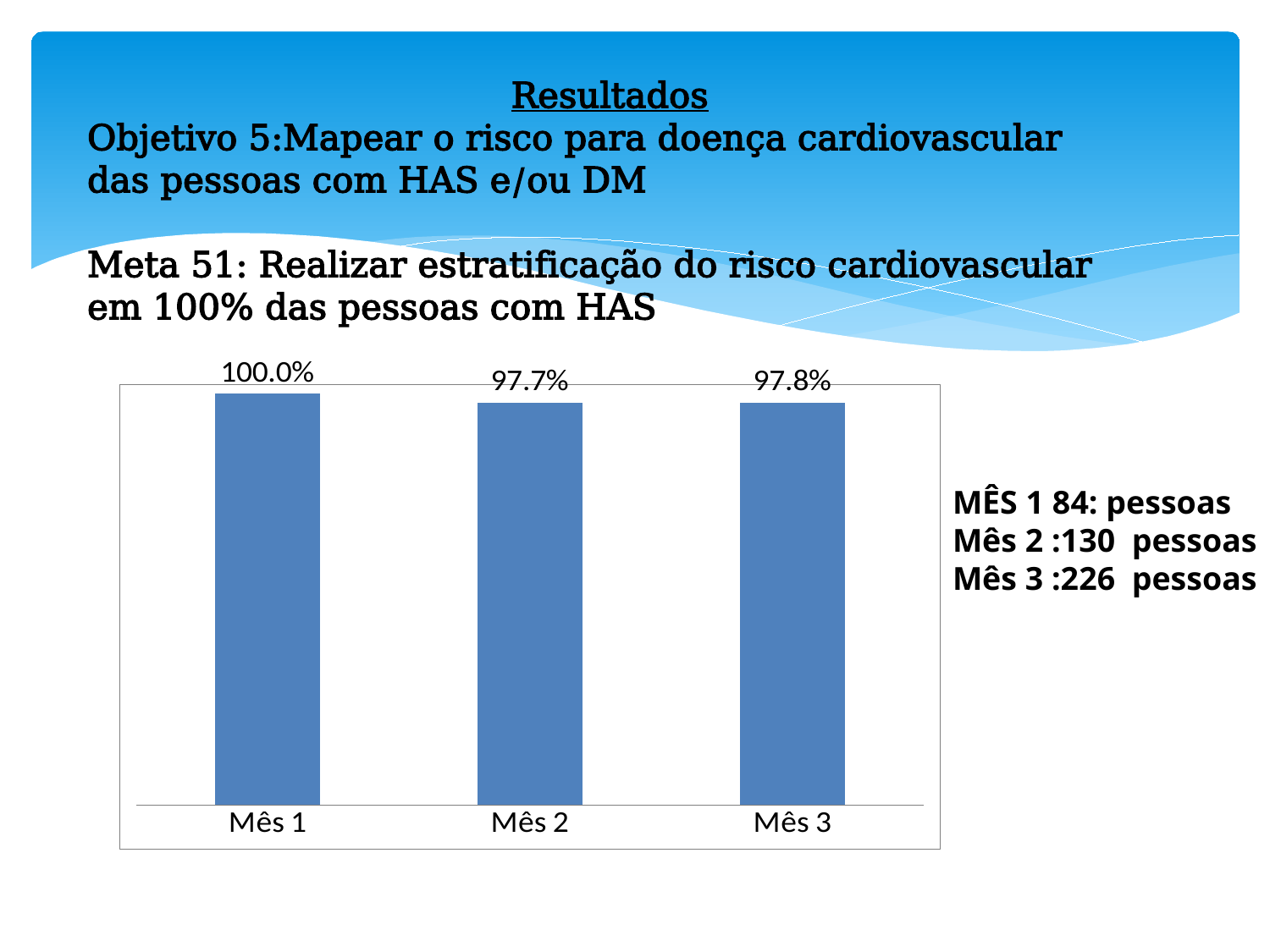
What kind of chart is shown on the slide? Bar chart What is the difference between the values for Mês 1 and Mês 3? 2.2 percentage points What is the value for Mês 2? 97.7% Does the value fall or rise from Mês 1 to Mês 2? Fall What is the value for Mês 1? 100.0% Which month has the highest value? Mês 1 Which is larger, the value for Mês 1 or the value for Mês 3? Mês 1 What colour are the bars in the chart? Blue Which is larger, the value for Mês 1 or the value for Mês 2? Mês 1 What is the value for Mês 3? 97.8% What is the difference between the values for Mês 1 and Mês 2? 2.3 percentage points How many categories are shown on the x axis? 3